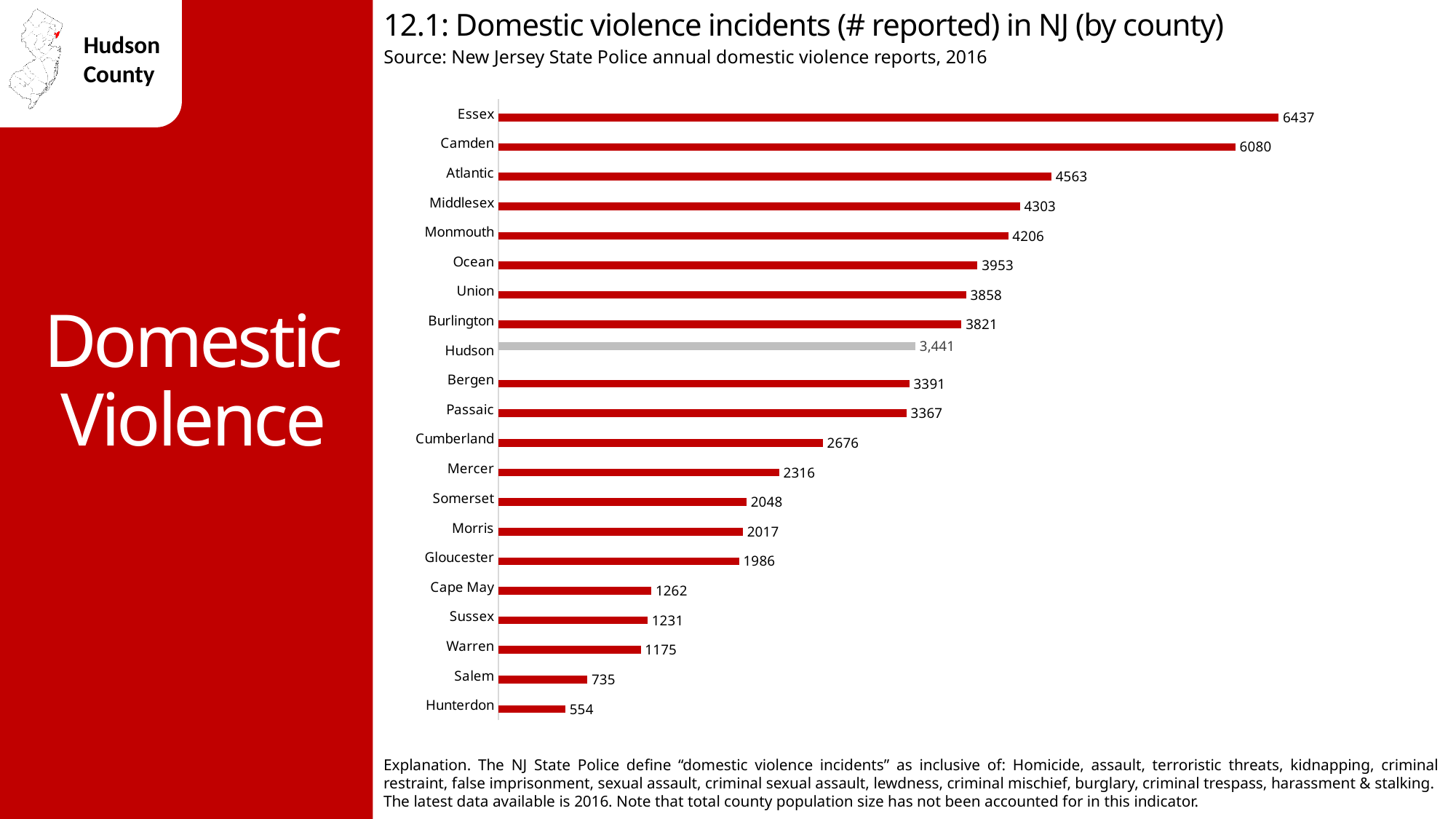
Which county has the lowest number of reported domestic violence incidents? Hunterdon What kind of chart is shown on the slide? Bar chart How many counties are shown in the chart? 21 Which county has more reported incidents, Mercer or Somerset? Mercer Which county has more reported incidents, Atlantic or Middlesex? Atlantic What value is shown for Cumberland? 2676 How many domestic violence incidents were reported in Hudson County? 3,441 Which county has the highest number of reported domestic violence incidents? Essex What is the difference between the values for Essex and Camden? 357 Which county's bar is coloured grey instead of red? Hudson What is the difference between the values for Salem and Hunterdon? 181 What is the number of reported domestic violence incidents for Essex? 6437